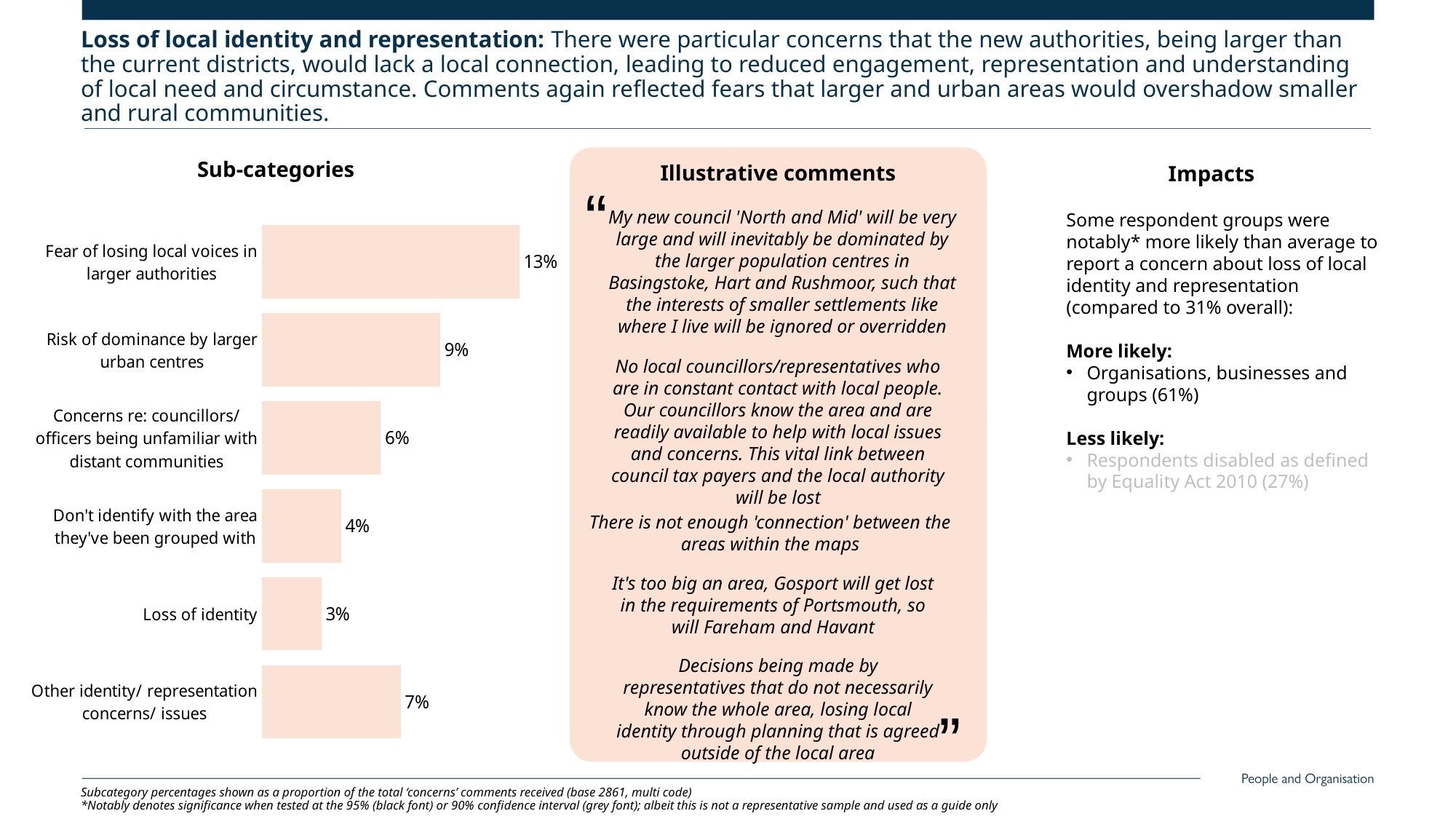
What is the title of the chart? Sub-categories What percentage is shown for 'Fear of losing local voices in larger authorities'? 13% What is the difference in percentage points between 'Fear of losing local voices in larger authorities' and 'Risk of dominance by larger urban centres'? 4 Which sub-category has the highest percentage? Fear of losing local voices in larger authorities What percentage is shown for 'Loss of identity'? 3% What percentage is shown for 'Other identity/ representation concerns/ issues'? 7% Which is larger: 'Concerns re: councillors/ officers being unfamiliar with distant communities' or 'Don't identify with the area they've been grouped with'? Concerns re: councillors/ officers being unfamiliar with distant communities What kind of chart is used to show the sub-categories? Bar chart What is the difference in percentage points between 'Other identity/ representation concerns/ issues' and 'Loss of identity'? 4 Which sub-category has the lowest percentage? Loss of identity How many sub-categories are shown in the chart? 6 What percentage is shown for 'Risk of dominance by larger urban centres'? 9%